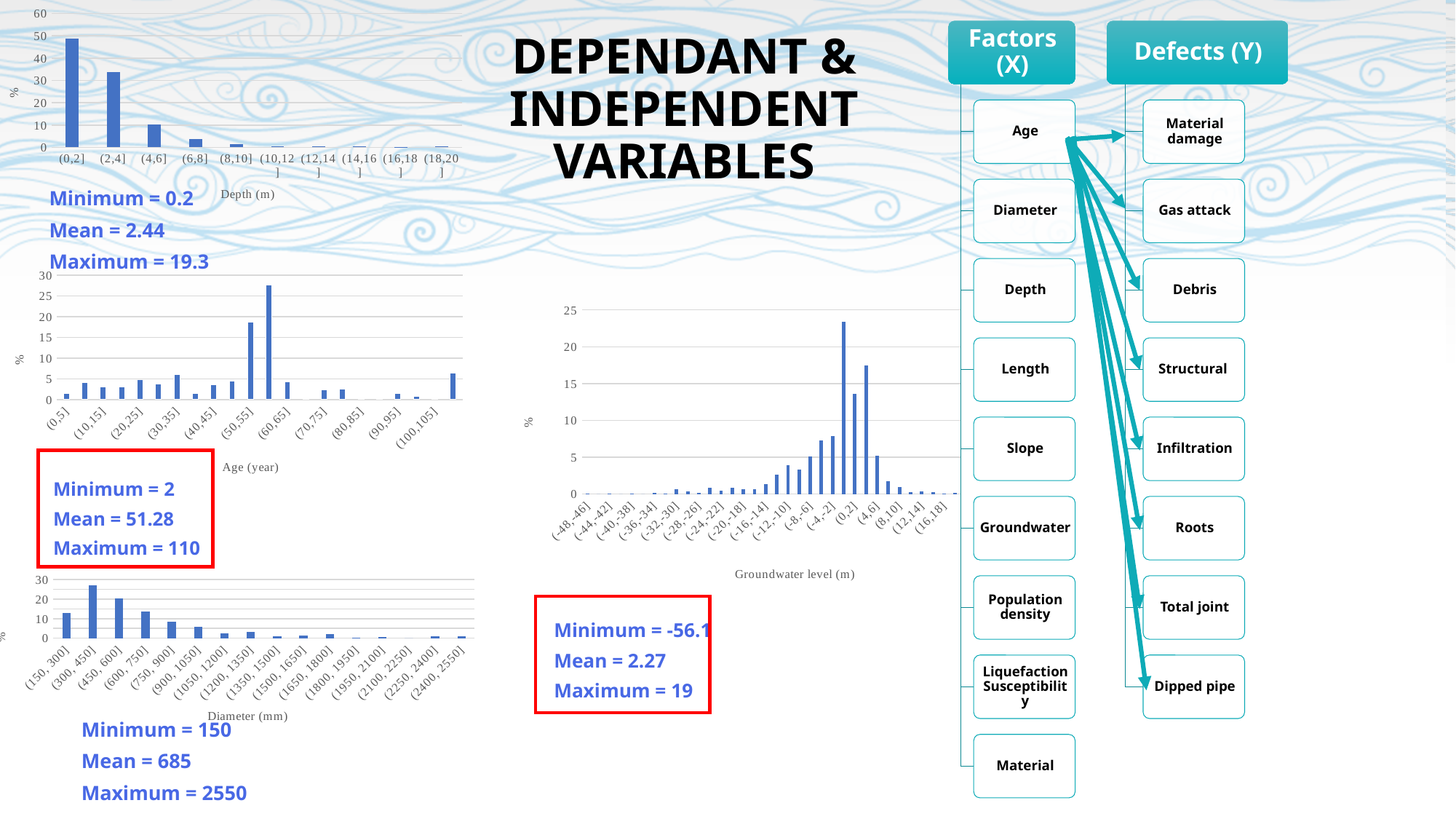
In the Age (year) chart, is the value for (50,55] greater or less than 20? less In the Depth (m) chart, is the value for (0,2] greater or less than 40? greater In the Diameter (mm) chart, which is larger, the value for (300,450] or the value for (450,600]? (300,450] In the Depth (m) chart, is the value for (4,6] greater or less than 20? less What kind of chart is the Age (year) chart? bar chart In the Depth (m) chart, how many depth categories are shown on the x axis? 10 In the Depth (m) chart, which depth category has the highest percentage? (0,2] In the Diameter (mm) chart, which diameter category has the highest percentage? (300,450] In the Depth (m) chart, do the values generally rise or fall as depth increases along the x axis? fall